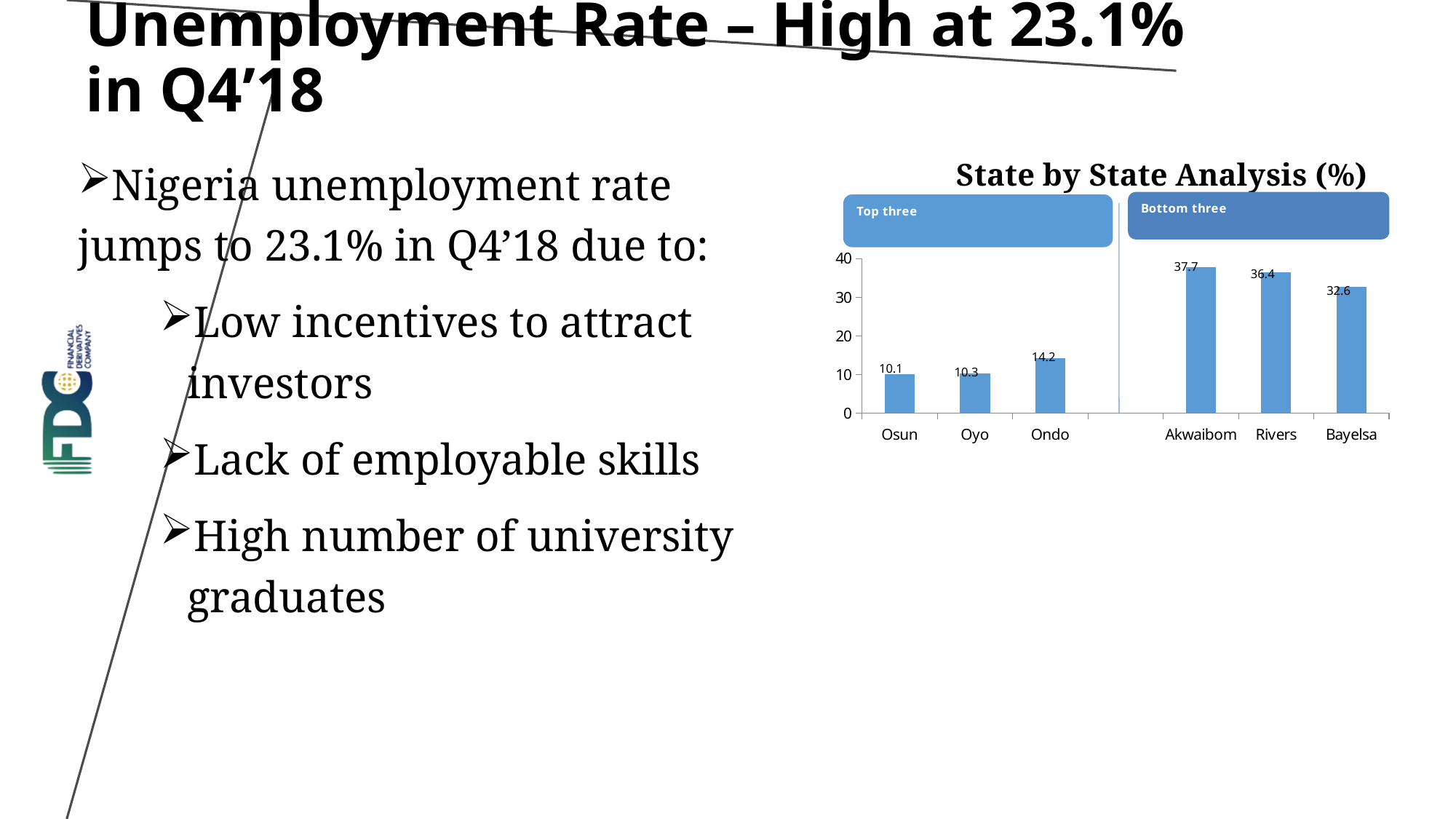
What are the two group labels shown above the bars in the chart? Top three and Bottom three Is the value for Rivers greater or less than 30? greater What is the value for Akwaibom in the State by State Analysis chart? 37.7 Which has a larger value, Ondo or Bayelsa? Bayelsa What is the difference between the values for Akwaibom and Rivers? 1.3 Which state has the lowest value in the State by State Analysis chart? Osun How many states are shown in the State by State Analysis chart? 6 Which state has the highest value in the State by State Analysis chart? Akwaibom What is the difference between the values for Ondo and Oyo? 3.9 What kind of chart is the State by State Analysis? Bar chart What is the value for Bayelsa in the State by State Analysis chart? 32.6 What is the value for Osun in the State by State Analysis chart? 10.1